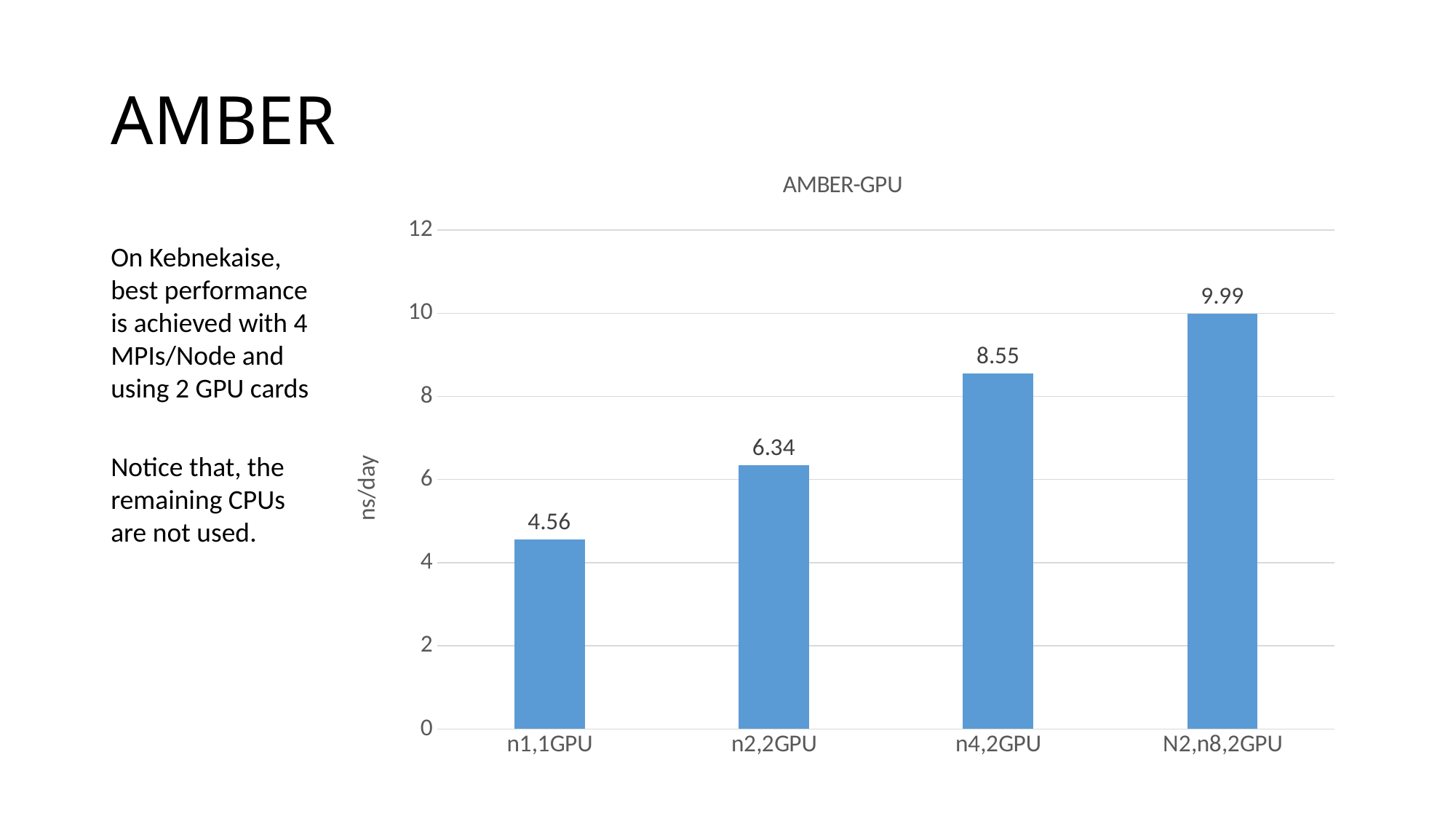
What is the value for N2,n8,2GPU in the AMBER-GPU chart? 9.99 How many categories are shown in the AMBER-GPU chart? 4 What is the difference between the values for N2,n8,2GPU and n4,2GPU in the AMBER-GPU chart? 1.44 What kind of chart is the AMBER-GPU chart? bar chart Which is larger in the AMBER-GPU chart, the value for n2,2GPU or the value for n4,2GPU? n4,2GPU What is the difference between the values for n2,2GPU and n1,1GPU in the AMBER-GPU chart? 1.78 What is the value for n1,1GPU in the AMBER-GPU chart? 4.56 Is the value for n2,2GPU greater or less than 6 in the AMBER-GPU chart? greater Which category has the highest value in the AMBER-GPU chart? N2,n8,2GPU What is the value for n4,2GPU in the AMBER-GPU chart? 8.55 Which category has the lowest value in the AMBER-GPU chart? n1,1GPU Do the values in the AMBER-GPU chart rise or fall from left to right along the x axis? rise